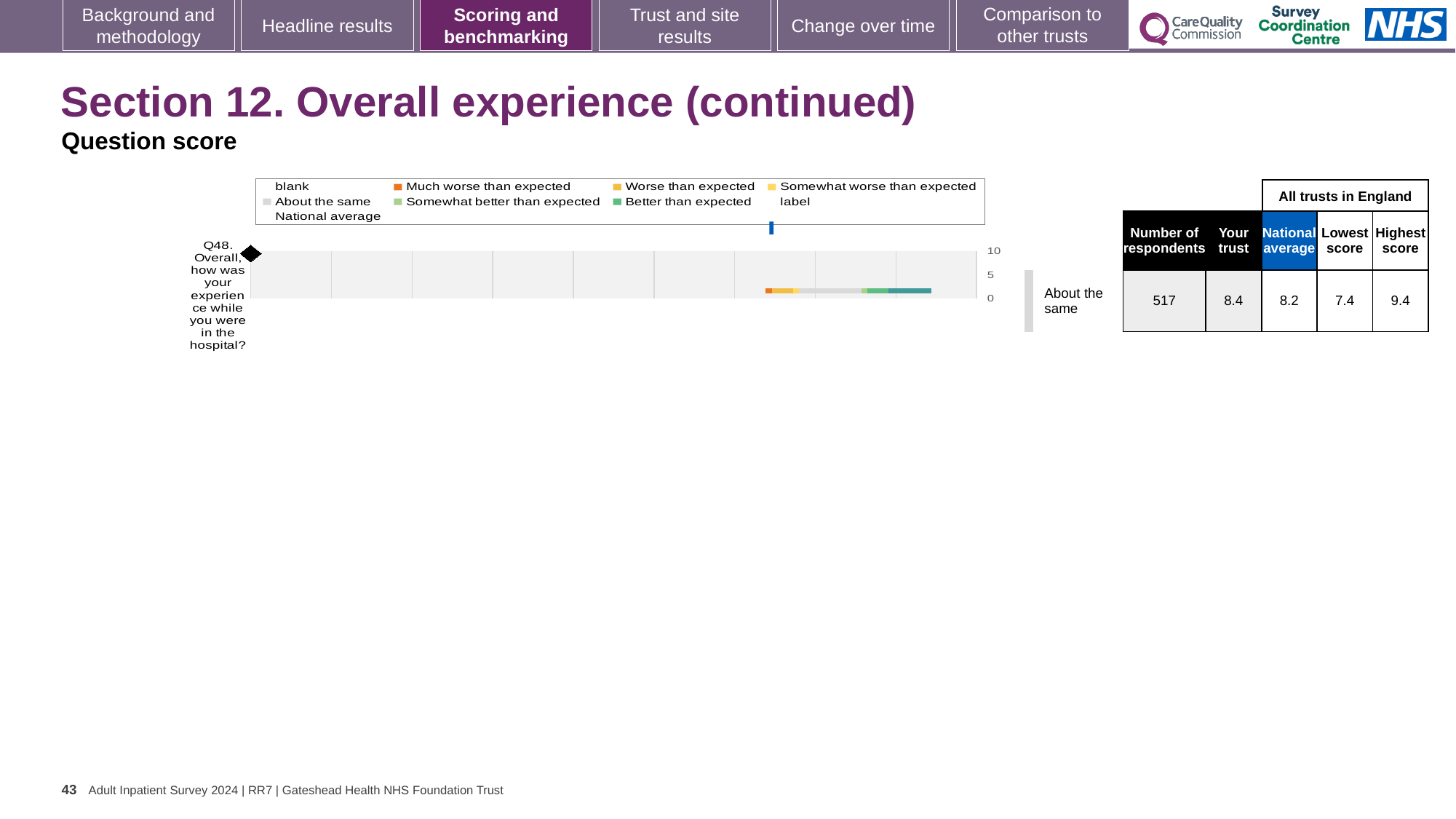
How many questions are plotted in the chart? 1 How many respondents answered Q48? 517 What is the 'Your trust' score for Q48? 8.4 What is the national average score for Q48? 8.2 What colour represents 'Much worse than expected' in the chart legend? orange What is the lowest score among all trusts in England for Q48? 7.4 What is the difference between the 'Your trust' score and the national average for Q48? 0.2 What is the highest score among all trusts in England for Q48? 9.4 Which question is plotted in the chart? Q48. Overall, how was your experience while you were in the hospital? What type of chart is used to show the Q48 question score? bar chart Which is larger for Q48, the 'Your trust' score or the national average? Your trust What is the difference between the highest and lowest scores among all trusts in England for Q48? 2.0